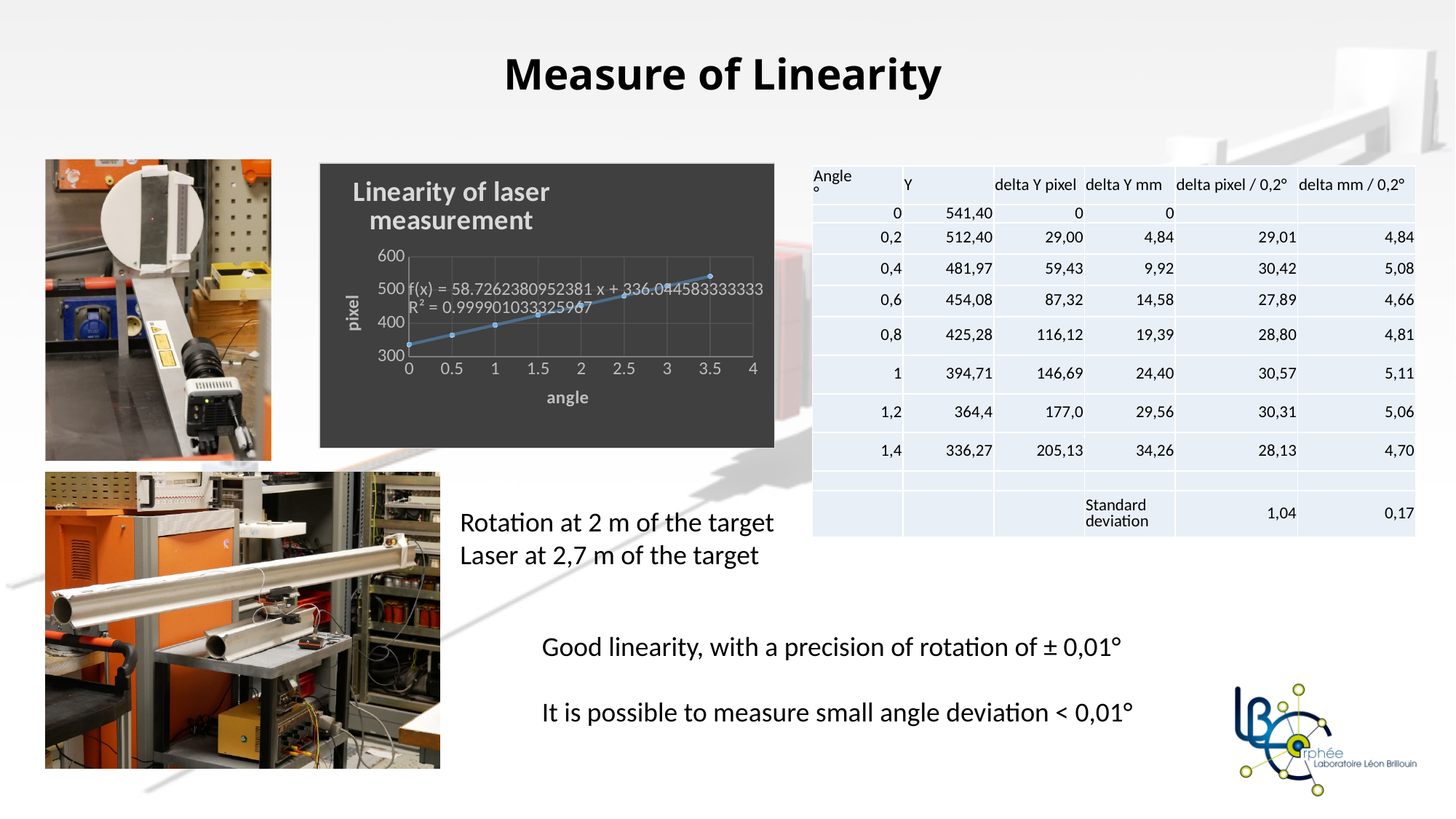
Is the pixel value at angle 0 greater or less than 400? less At which angle is the plotted pixel value highest? 3.5 Is the pixel value at angle 3.5 greater or less than 500? greater Do the pixel values rise or fall as the angle increases? rise What kind of chart is shown on the slide? scatter chart with a trendline At which angle is the plotted pixel value lowest? 0 Which has the larger pixel value, angle 1 or angle 3? angle 3 Is the pixel value at angle 2 greater or less than 500? less What R² value is shown for the trendline in the chart? 0.999901033325967 How many data points are plotted in the chart? 8 What is the title of the chart? Linearity of laser measurement What is the label of the x axis of the chart? angle